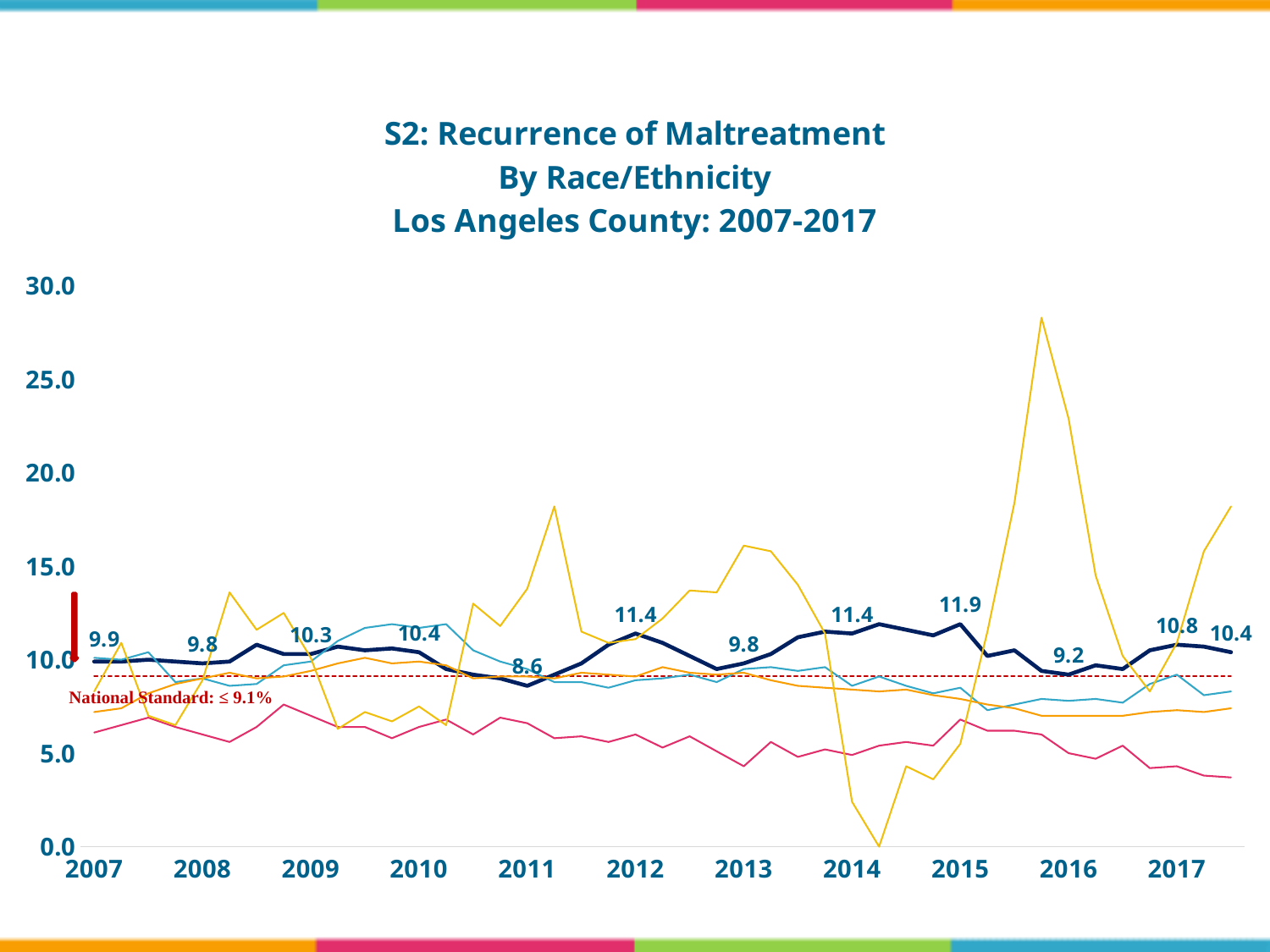
In which year does the dark blue line reach its lowest labeled value? 2011 What is the title of the chart? S2: Recurrence of Maltreatment By Race/Ethnicity Los Angeles County: 2007-2017 How many years are labeled on the x axis? 11 Which year has the larger labeled value on the dark blue line, 2012 or 2013? 2012 What is the labeled value of the dark blue line for 2007? 9.9 What is the labeled value of the dark blue line for 2015? 11.9 What kind of chart is shown on the slide? line chart Is the highest point of the yellow line greater or less than 25.0? greater What is the difference between the dark blue line's labeled values for 2015 and 2011? 3.3 What national standard is shown by the dashed red line? ≤ 9.1% In which year does the dark blue line reach its highest labeled value? 2015 What is the labeled value of the dark blue line for 2011? 8.6